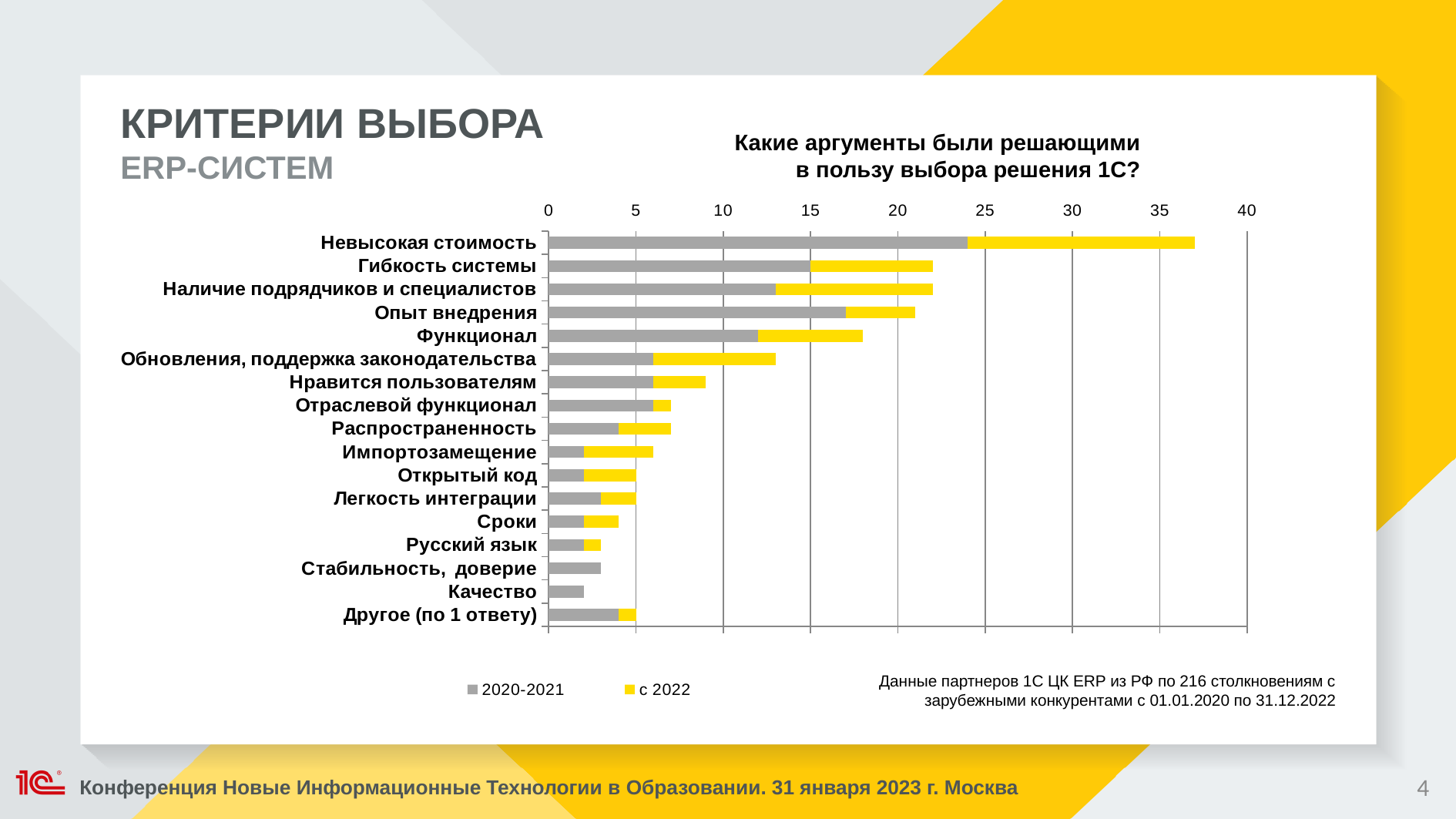
How many series does the chart legend list? 2 How many categories are plotted on the chart? 17 Which category has the longest total bar? Невысокая стоимость Which colour represents the series 'с 2022' in the chart? Yellow Which category has the shortest total bar? Качество Is the total value for Гибкость системы greater or less than 20? greater Is the total value for Функционал greater or less than 20? less Which has a larger total bar: Опыт внедрения or Функционал? Опыт внедрения Is the total value for Невысокая стоимость greater or less than 35? greater What is the title of the chart? Какие аргументы были решающими в пользу выбора решения 1С? What kind of chart is shown on the slide? Bar chart